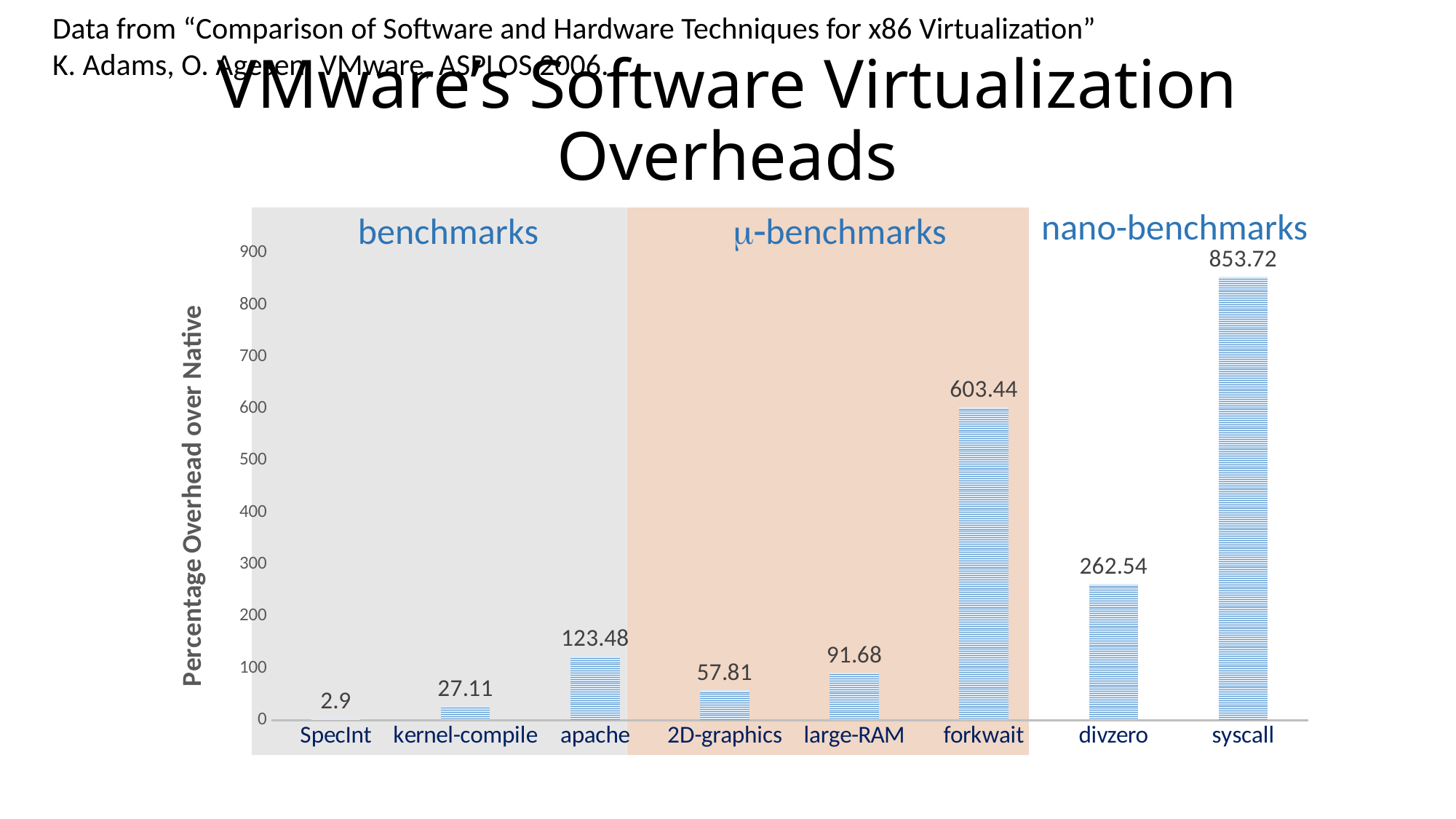
Which category has the highest percentage overhead over native? syscall What kind of chart is shown on the slide? bar chart Which category has the lowest percentage overhead over native? SpecInt What is the percentage overhead over native for SpecInt? 2.9 Which has a larger percentage overhead over native, divzero or apache? divzero What is the percentage overhead over native for syscall? 853.72 What is the percentage overhead over native for large-RAM? 91.68 How many categories are plotted on the chart? 8 What is the difference in percentage overhead between apache and kernel-compile? 96.37 What is the percentage overhead over native for forkwait? 603.44 What is the label of the vertical axis? Percentage Overhead over Native What is the difference in percentage overhead between syscall and forkwait? 250.28